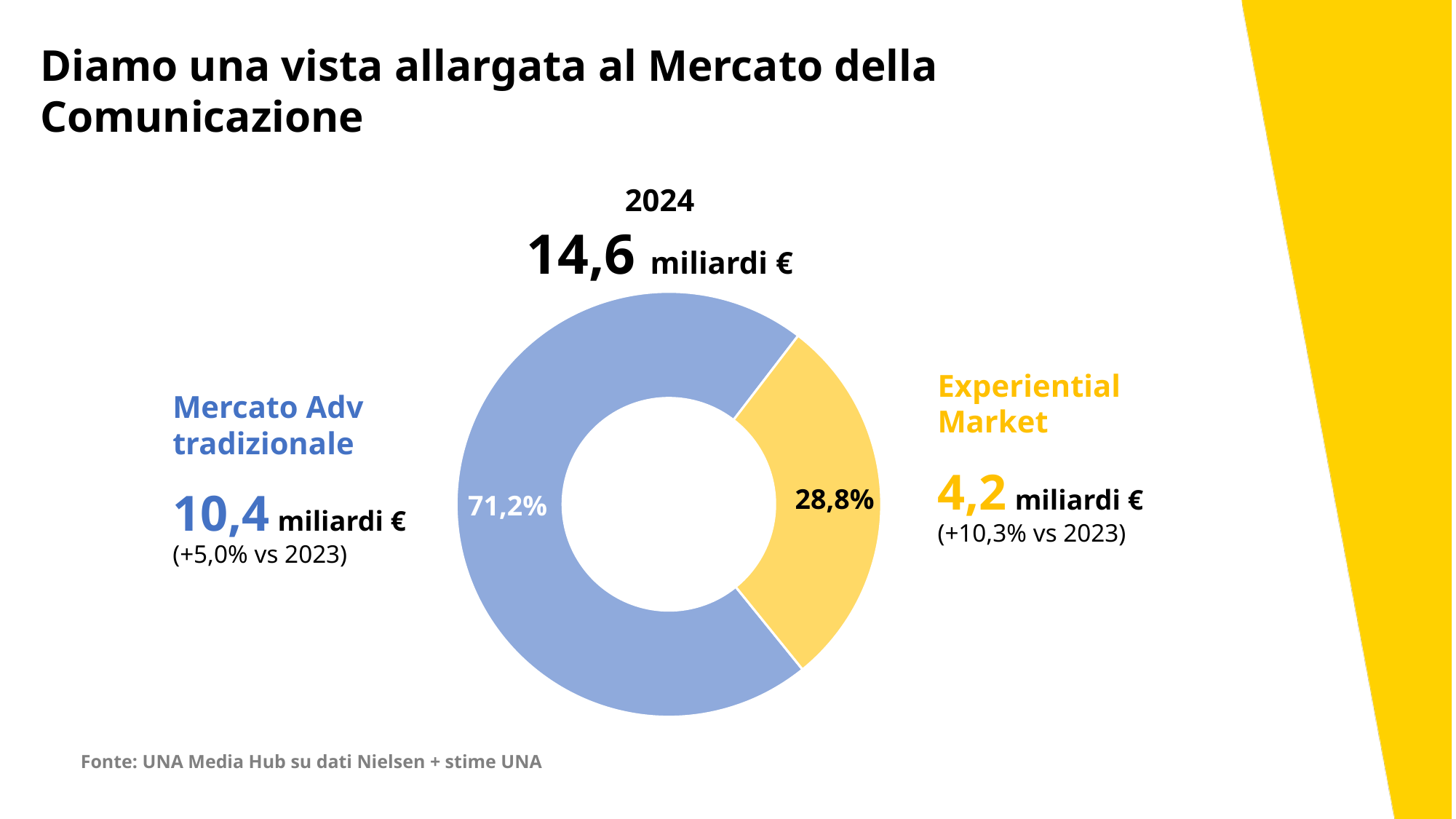
What share of the donut chart does Mercato Adv tradizionale represent? 71,2% What share of the donut chart does Experiential Market represent? 28,8% What colour is the Experiential Market segment of the donut chart? Yellow What is the total value of the market shown above the donut chart for 2024? 14,6 miliardi € What kind of chart is shown on the slide? Donut (pie) chart Which segment of the donut chart is the largest? Mercato Adv tradizionale Which segment of the donut chart is the smallest? Experiential Market What is the value in miliardi € for Experiential Market? 4,2 miliardi € Which is larger: the share for Mercato Adv tradizionale or the share for Experiential Market? Mercato Adv tradizionale How many segments does the donut chart have? 2 What is the value in miliardi € for Mercato Adv tradizionale? 10,4 miliardi € What is the difference in percentage points between the Mercato Adv tradizionale share and the Experiential Market share? 42,4 percentage points